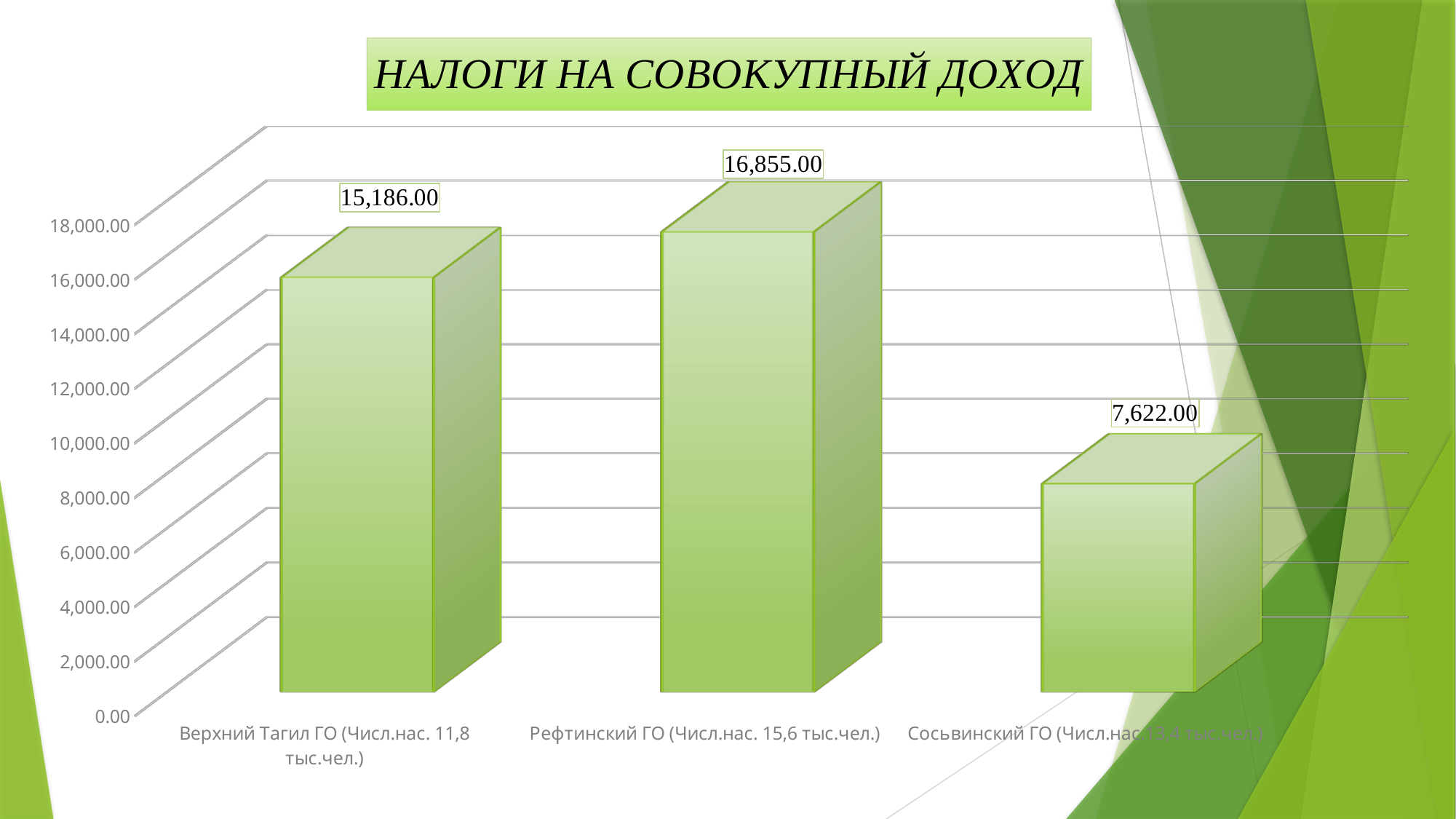
What is the difference between the values for Верхний Тагил ГО and Сосьвинский ГО? 7,564.00 Is the value for Сосьвинский ГО greater or less than 10,000.00? less What is the value for Рефтинский ГО? 16,855.00 How many categories are shown in the chart? 3 What is the title of the chart? НАЛОГИ НА СОВОКУПНЫЙ ДОХОД Which is larger, the value for Верхний Тагил ГО or the value for Сосьвинский ГО? Верхний Тагил ГО What is the value for Сосьвинский ГО? 7,622.00 What is the difference between the values for Рефтинский ГО and Верхний Тагил ГО? 1,669.00 What is the value for Верхний Тагил ГО? 15,186.00 What kind of chart is shown on the slide? bar chart Which category has the lowest value? Сосьвинский ГО Which category has the highest value? Рефтинский ГО